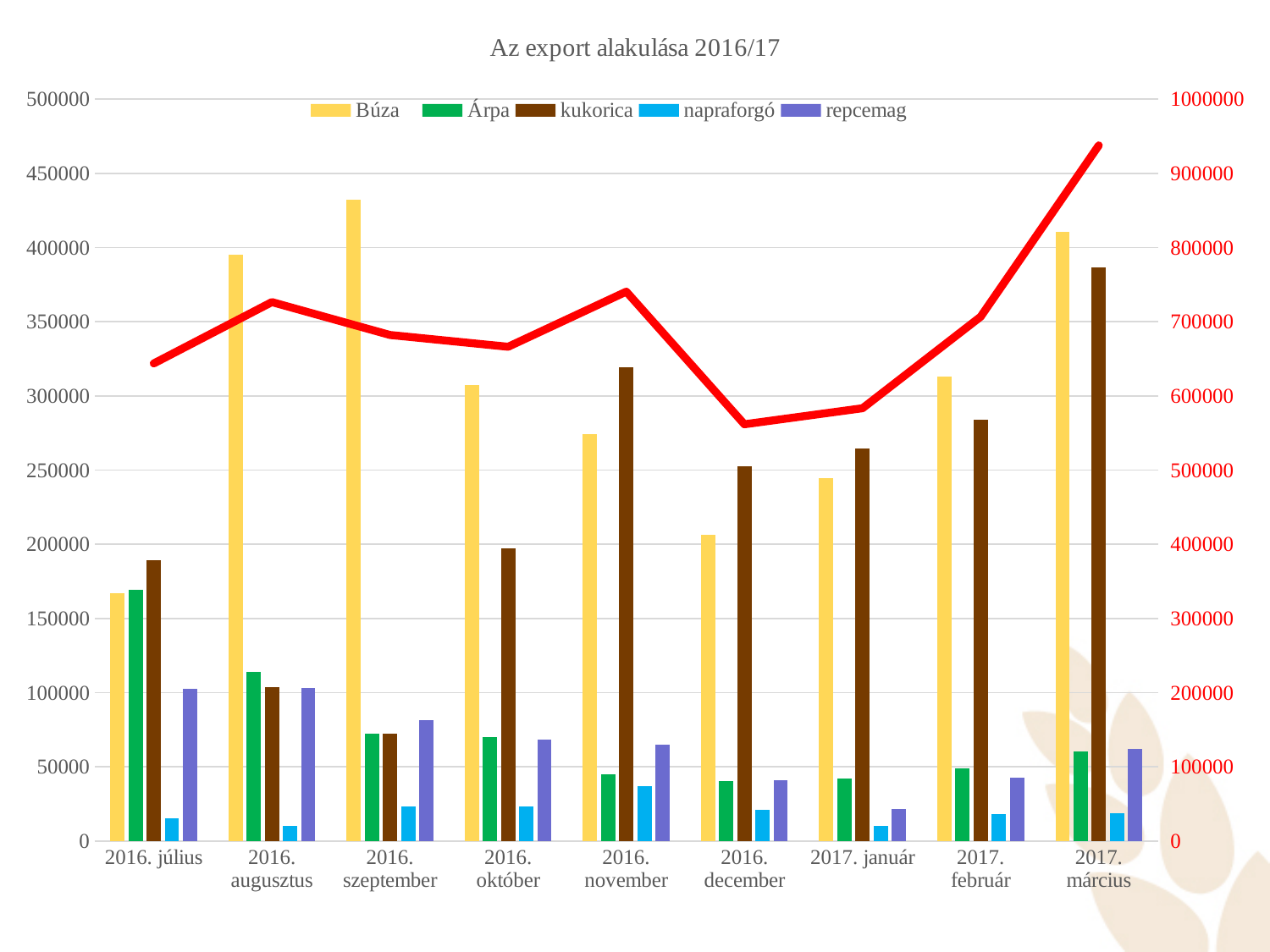
In which month is the Búza bar lowest? 2016. július What kind of chart is this? Bar chart combined with a line In which month is the Árpa bar highest? 2016. július In which month is the Búza bar highest? 2016. szeptember In 2016. november, which is larger, Búza or kukorica? kukorica Is the kukorica value for 2016. november greater or less than 300000? greater Is the Búza value for 2016. szeptember greater or less than 400000? greater What is the title of the chart? Az export alakulása 2016/17 How many series does the legend list? 5 In which month is the kukorica bar lowest? 2016. szeptember In which month is the kukorica bar highest? 2017. március How many months are shown on the x axis? 9